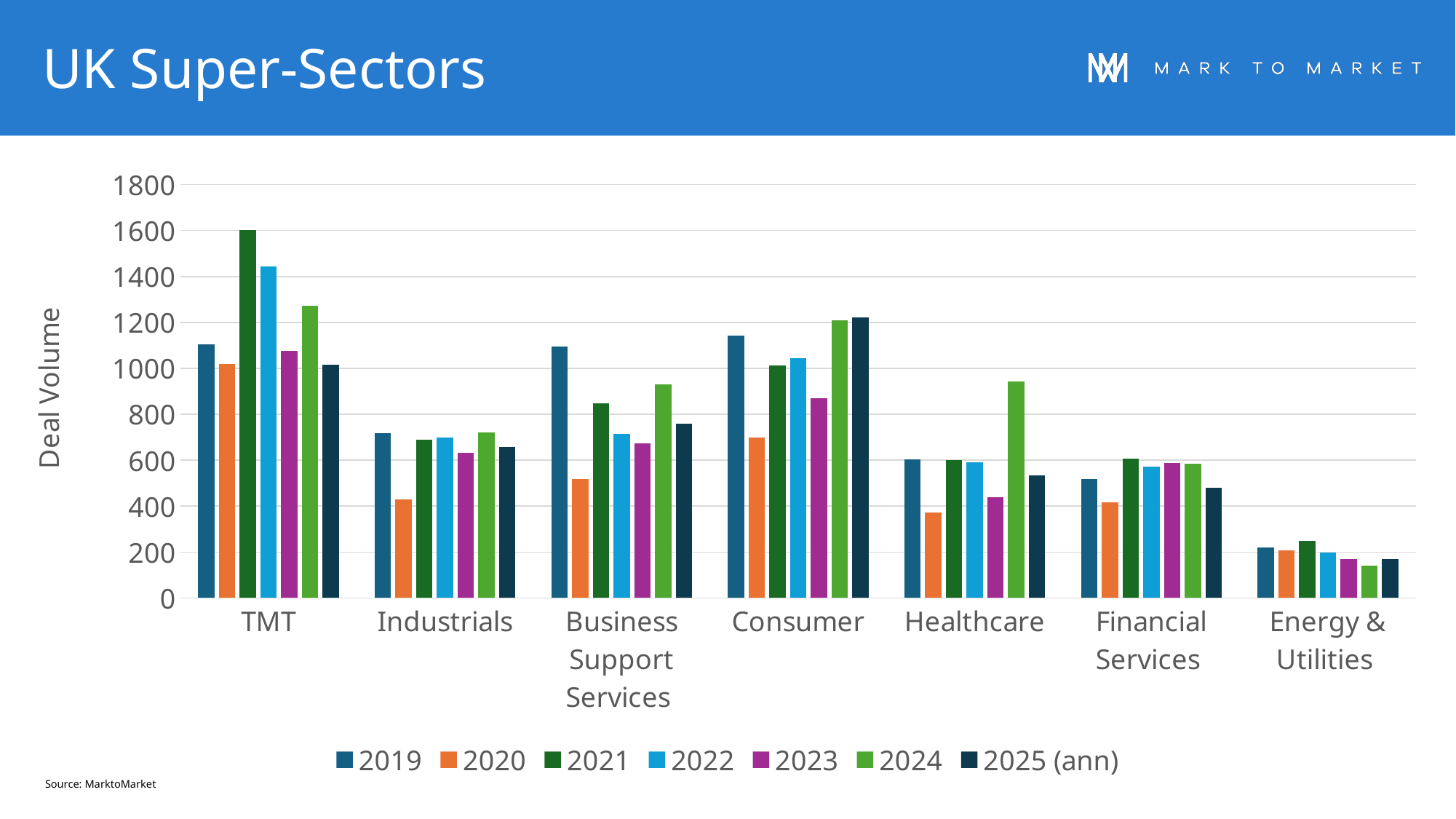
Is the 2021 deal volume for TMT greater or less than 1400? greater For Healthcare, which is larger: the 2024 deal volume or the 2019 deal volume? 2024 For Business Support Services, which is larger: the 2019 deal volume or the 2021 deal volume? 2019 Which super-sector has the lowest deal volume for 2024? Energy & Utilities Is the 2020 deal volume for Healthcare greater or less than 400? less Which super-sector has the highest deal volume for 2021? TMT How many series does the legend list? 7 What kind of chart is shown on the slide? bar chart Is the 2024 deal volume for Consumer greater or less than 1000? greater How many super-sector categories are shown on the x axis? 7 What is the label on the vertical axis? Deal Volume Within TMT, which year has the highest deal volume? 2021